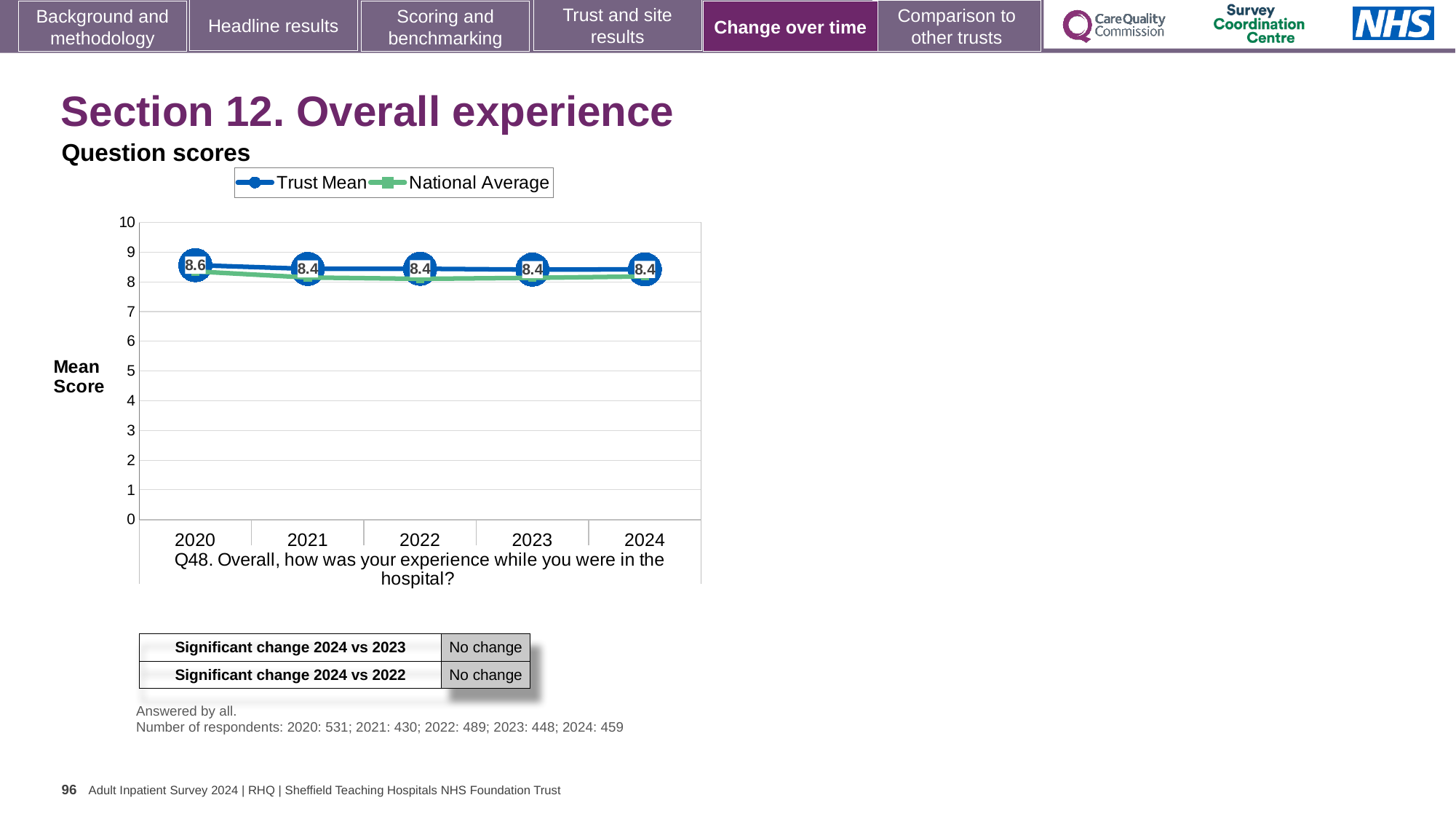
Which is larger, the Trust Mean for 2020 or for 2021? 2020 What is the difference between the Trust Mean in 2020 and in 2024? 0.2 Is the National Average value for 2024 greater or less than 7? greater Is the National Average value for 2021 greater or less than 9? less How many series does the legend list? 2 What kind of chart is shown on the slide? line chart In which year is the Trust Mean highest? 2020 Does the Trust Mean rise or fall from 2020 to 2024? fall What is the Trust Mean value for 2024? 8.4 What is the Trust Mean value for 2020? 8.6 What is the label on the y axis of the chart? Mean Score How many years are plotted on the x axis? 5